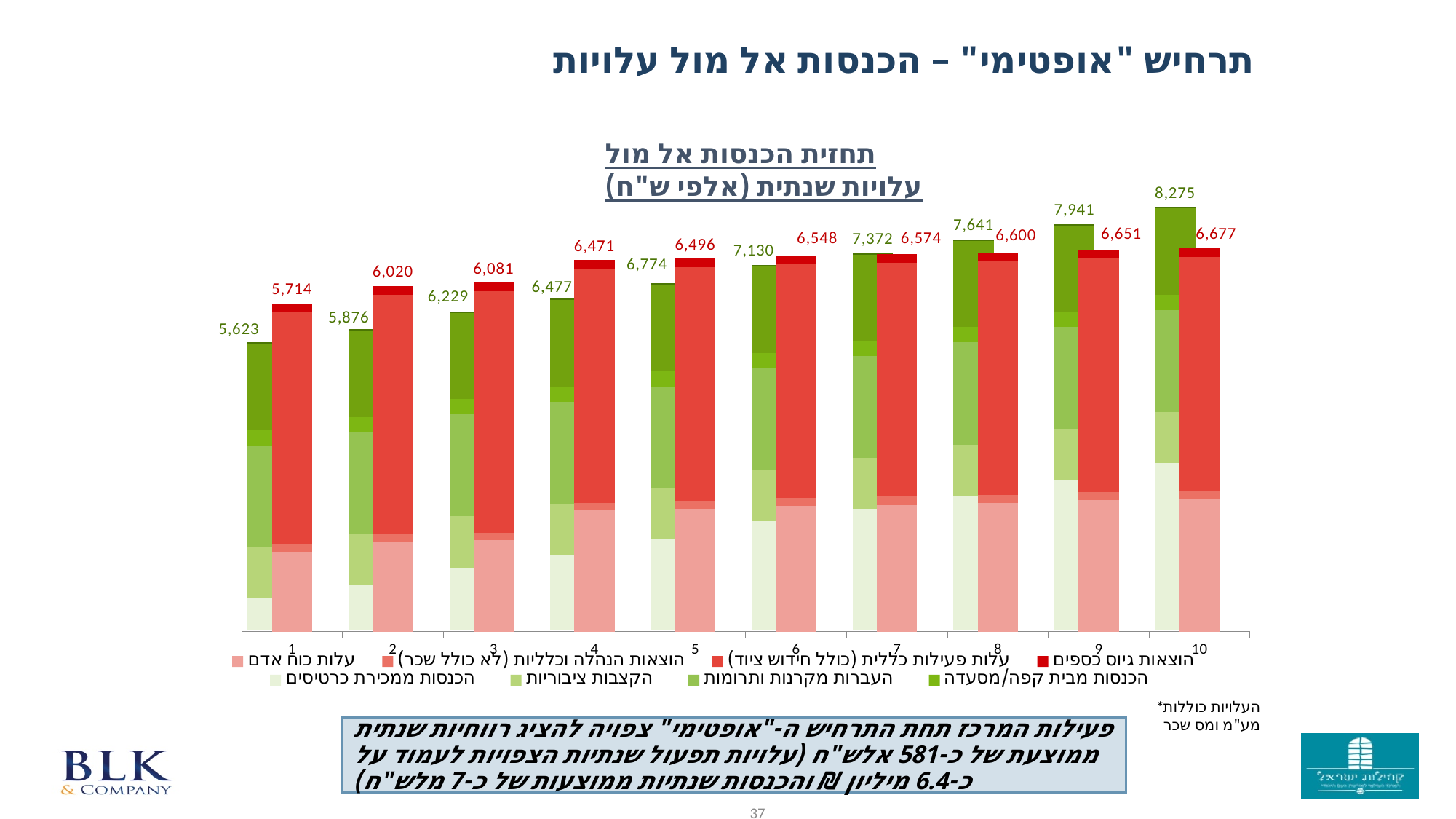
What kind of chart is shown on the slide? Stacked bar chart In which year is the total income (green bar) highest? Year 10 What is the total income (green bar) in year 1? 5,623 What is the total cost (red bar) in year 10? 6,677 How many series does the legend list? 8 In which year is the total cost (red bar) lowest? Year 1 What is the total income (green bar) in year 6? 7,130 In year 5, which is larger: total income (green bar) or total cost (red bar)? Total income (6,774) What is the difference between total income and total cost in year 10? 1,598 In year 2, which is larger: total income (green bar) or total cost (red bar)? Total cost (6,020) How many years are shown on the x axis? 10 Do the total income values (green bars) rise or fall from year 1 to year 10? Rise